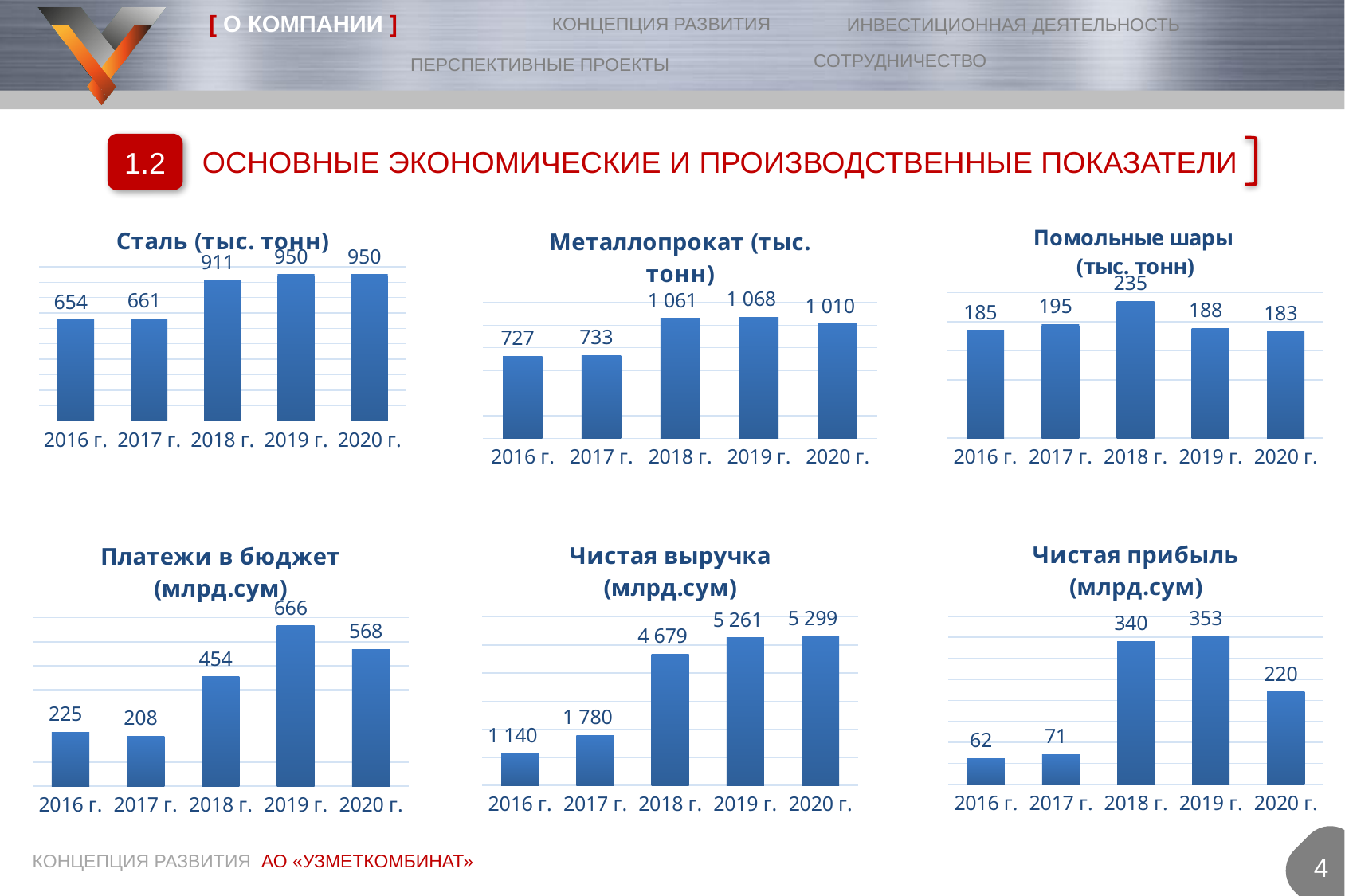
In the chart titled "Металлопрокат (тыс. тонн)", what is the difference between the values for 2017 г. and 2016 г.? 6 In the chart titled "Чистая выручка (млрд.сум)", what is the value for 2016 г.? 1 140 In the chart titled "Сталь (тыс. тонн)", what is the value for 2018 г.? 911 In the chart titled "Металлопрокат (тыс. тонн)", which year has the highest value? 2019 г. In the chart titled "Платежи в бюджет (млрд.сум)", what is the difference between the values for 2019 г. and 2020 г.? 98 In the chart titled "Помольные шары (тыс. тонн)", which year has the lowest value? 2020 г. In the chart titled "Чистая выручка (млрд.сум)", do the values rise or fall from 2016 г. to 2020 г.? rise How many charts are shown on the slide? 6 What kind of chart is the chart titled "Чистая выручка (млрд.сум)"? bar chart How many years are shown on the x axis of the chart titled "Сталь (тыс. тонн)"? 5 In the chart titled "Помольные шары (тыс. тонн)", what is the value for 2018 г.? 235 In the chart titled "Чистая прибыль (млрд.сум)", which is larger: the value for 2018 г. or the value for 2020 г.? 2018 г.